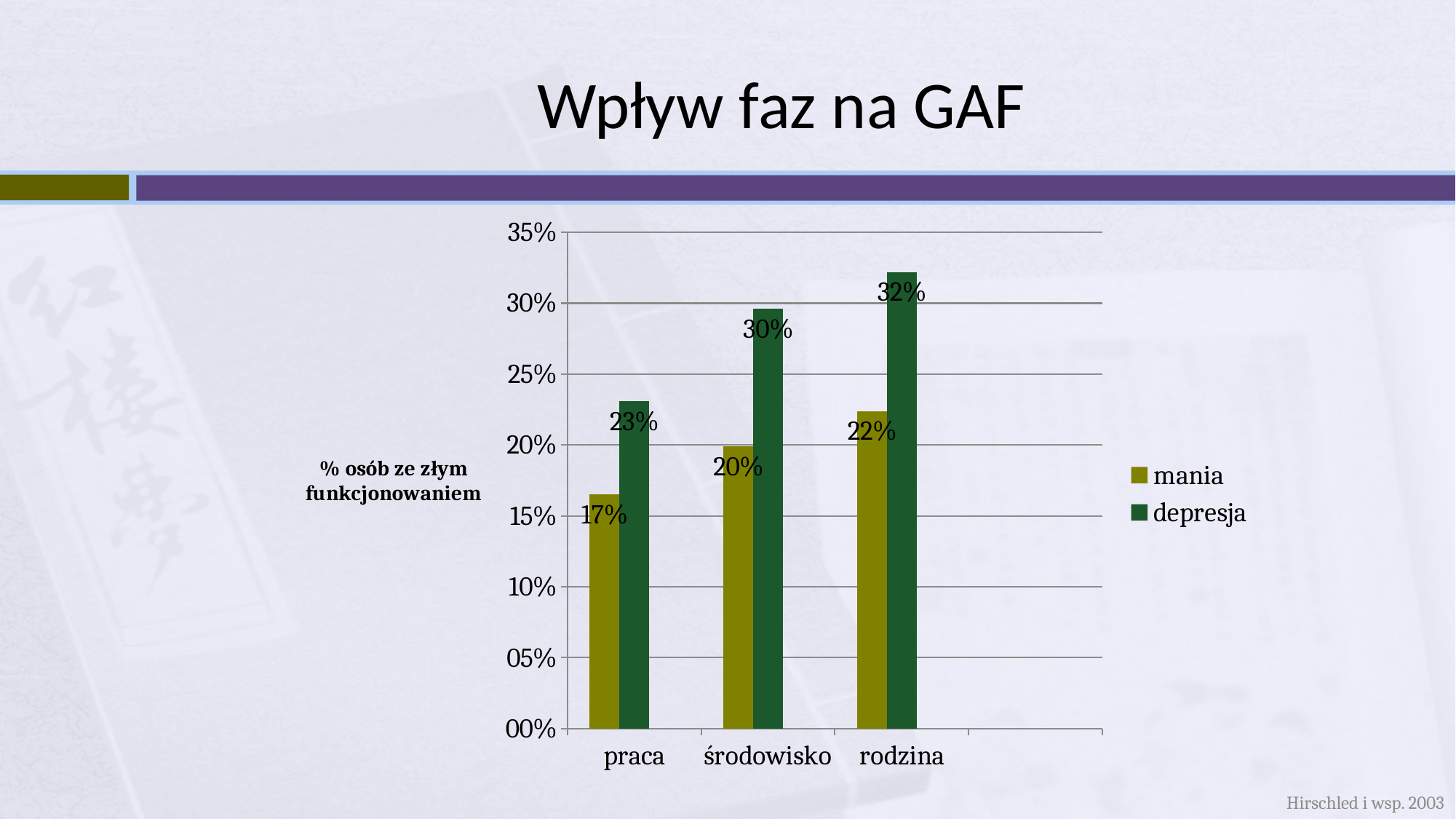
What is the difference between depresja and mania in the środowisko category? 10% Which is larger in the praca category, mania or depresja? depresja What is the value for depresja in the rodzina category? 32% How many series does the legend list? 2 How many categories are shown on the x axis? 3 Do the values for mania rise or fall from praca to rodzina? rise What is the value for mania in the rodzina category? 22% What is the value for mania in the praca category? 17% Which category has the highest value for depresja? rodzina What is the value for depresja in the środowisko category? 30% Which category has the lowest value for mania? praca What kind of chart is shown on the slide? bar chart